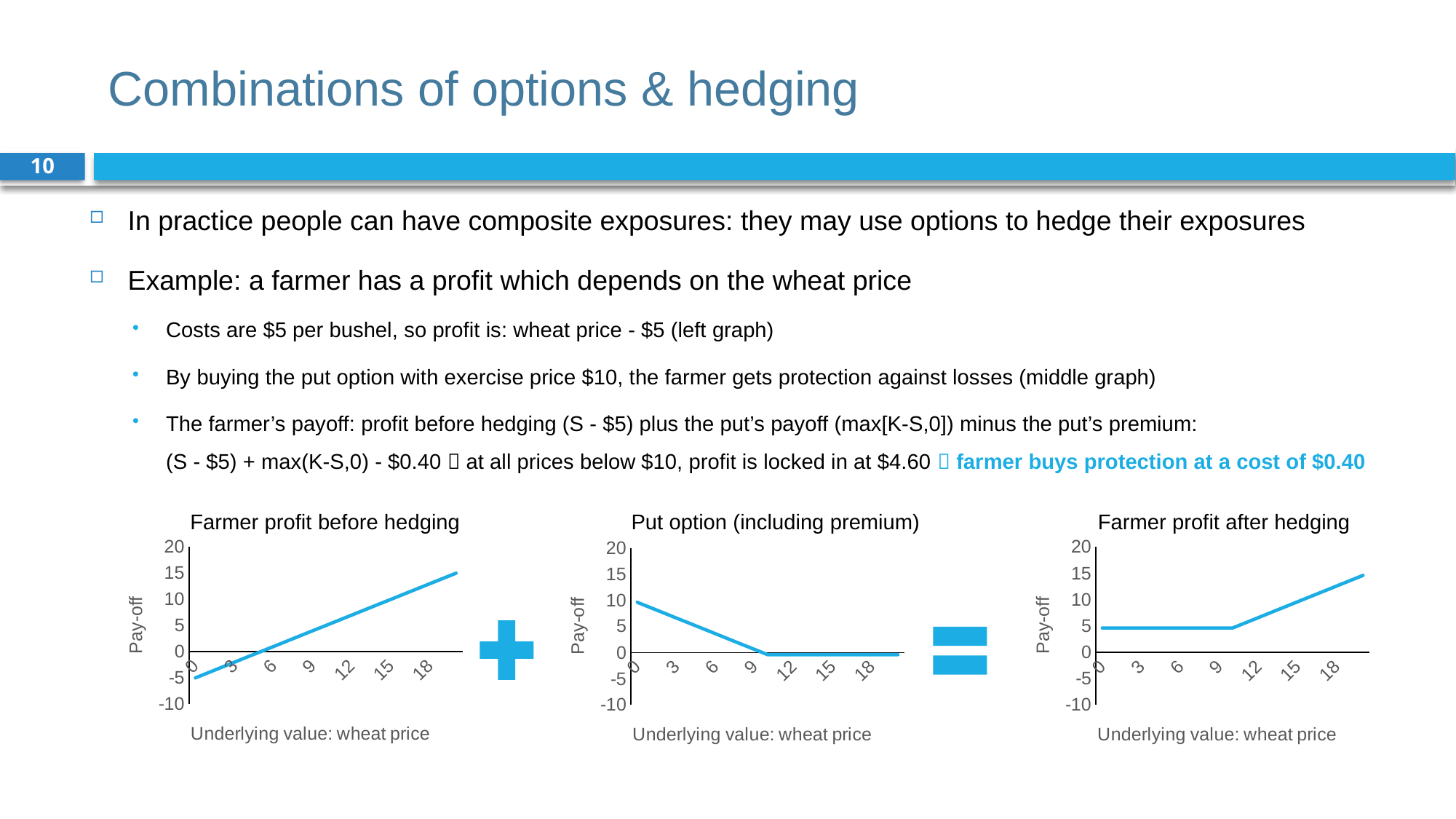
In the 'Farmer profit after hedging' chart, is the pay-off at a wheat price of 18 greater or less than 10? greater In the 'Farmer profit after hedging' chart, is the pay-off at a wheat price of 3 greater or less than 10? less In the 'Farmer profit after hedging' chart, is the pay-off at a wheat price of 6 greater or less than 0? greater In the 'Put option (including premium)' chart, does the pay-off rise or fall as the wheat price increases from 0 to 9? fall What is the y-axis label of the 'Farmer profit after hedging' chart? Pay-off In the 'Farmer profit before hedging' chart, does the pay-off rise or fall as the wheat price increases? rise How many charts are shown on the slide? 3 What is the x-axis label of the 'Put option (including premium)' chart? Underlying value: wheat price What kind of chart is the 'Farmer profit before hedging' chart? line chart